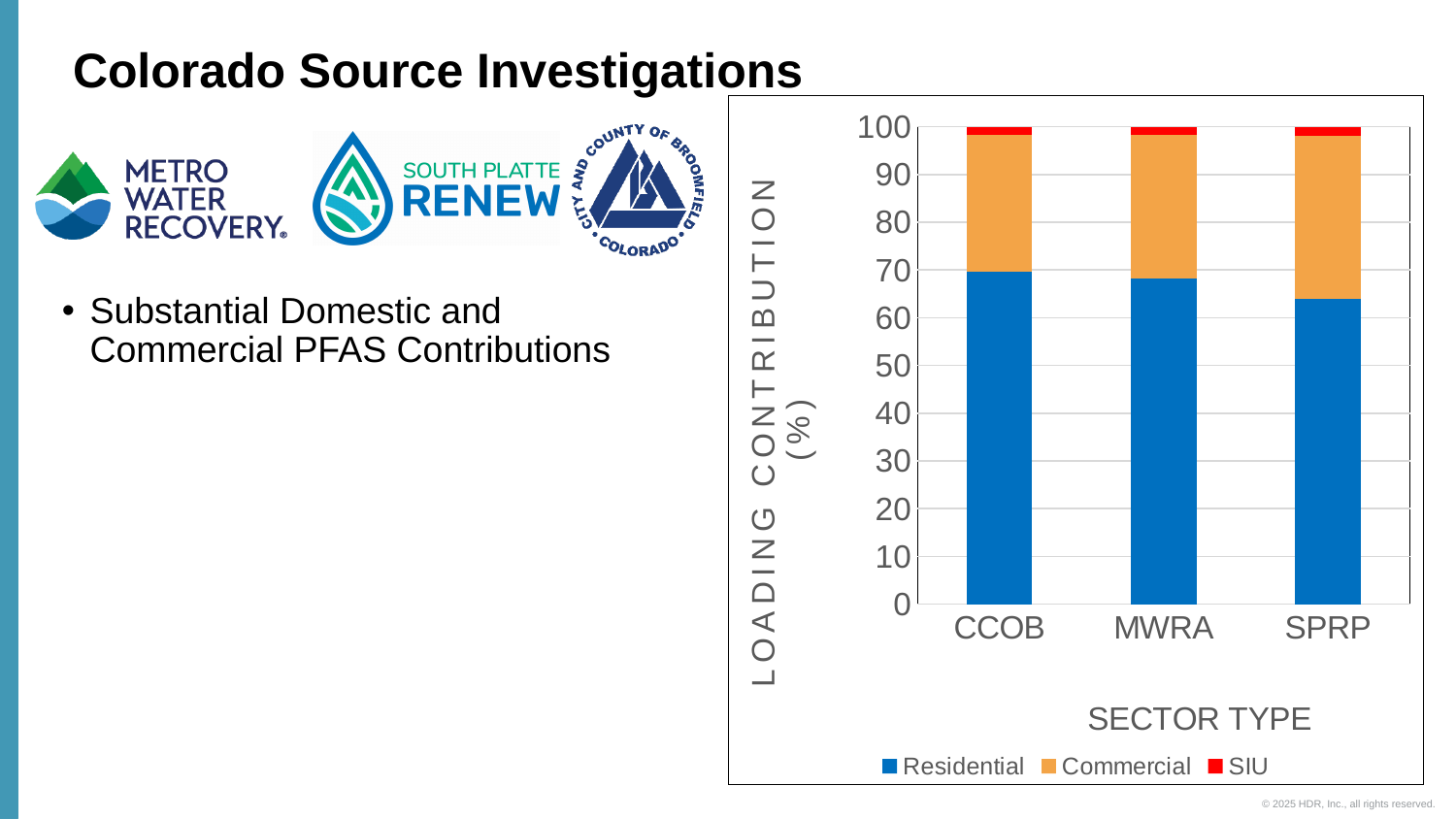
How many sector types are shown on the x axis of the chart? 3 What is the y-axis title of the chart? LOADING CONTRIBUTION (%) Is the Residential value for MWRA greater or less than 50? greater Which sector type has the lowest Residential contribution? SPRP What kind of chart is shown on the slide? Stacked bar chart Which series has the smallest share in every bar? SIU Is the Residential value for CCOB greater or less than 60? greater Is the Residential value for SPRP greater or less than 70? less What is the total height of the stacked bar for CCOB? 100 How many series does the chart legend list? 3 Which series are listed in the chart legend? Residential, Commercial, SIU Which has the larger Residential contribution, CCOB or SPRP? CCOB